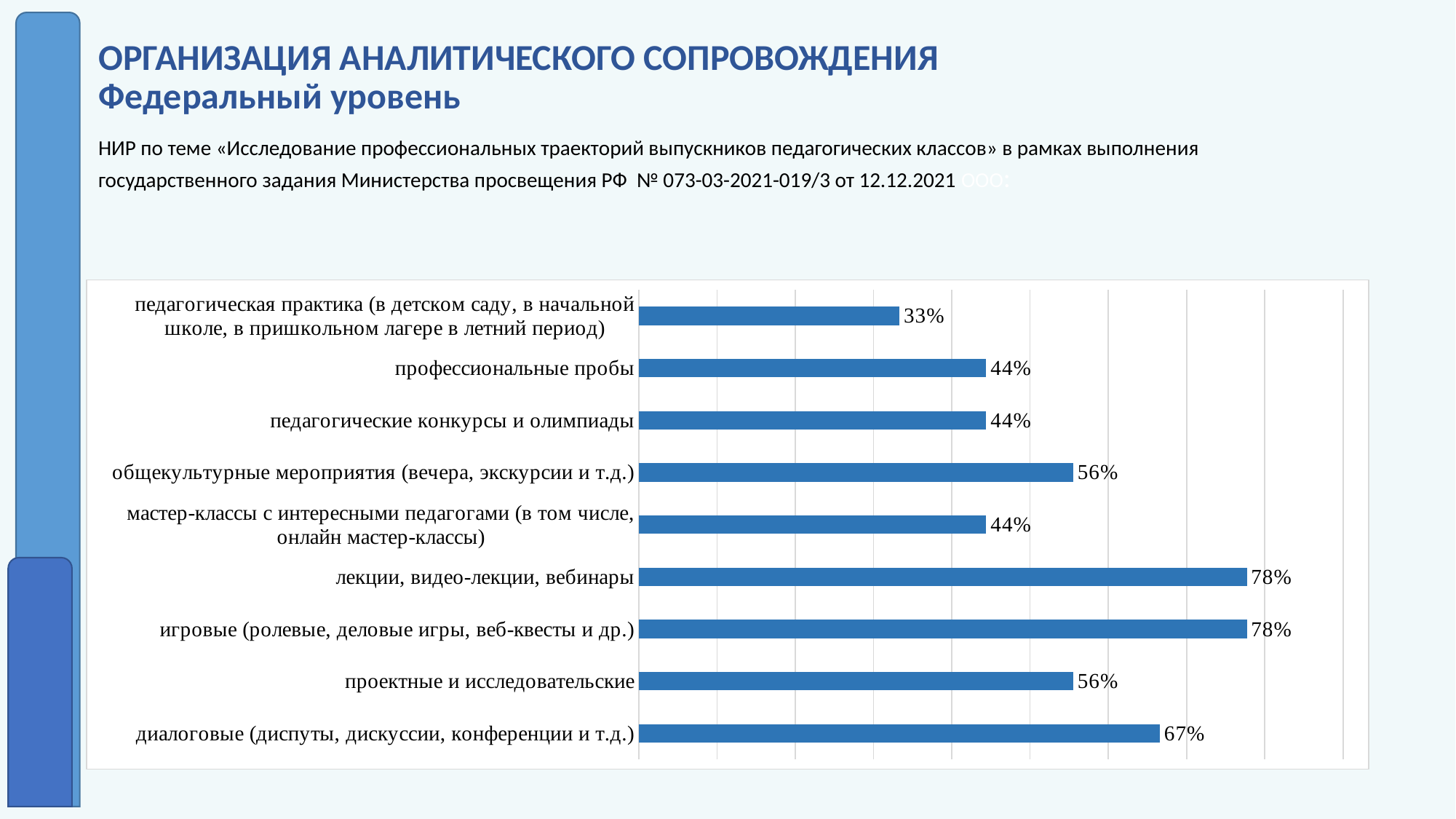
How many categories does the chart show? 9 What is the value for «лекции, видео-лекции, вебинары»? 78% What is the difference between the values for «игровые (ролевые, деловые игры, веб-квесты и др.)» and «общекультурные мероприятия (вечера, экскурсии и т.д.)»? 22% Which is larger: the value for «проектные и исследовательские» or the value for «педагогические конкурсы и олимпиады»? проектные и исследовательские What is the value for «профессиональные пробы»? 44% What is the value for «диалоговые (диспуты, дискуссии, конференции и т.д.)»? 67% How many categories have a value of 44%? 3 What kind of chart is shown on the slide? bar chart Which category has the lowest value? педагогическая практика (в детском саду, в начальной школе, в пришкольном лагере в летний период) What is the difference between the values for «диалоговые (диспуты, дискуссии, конференции и т.д.)» and «педагогическая практика»? 34% What is the highest value shown in the chart? 78% What is the value for «проектные и исследовательские»? 56%